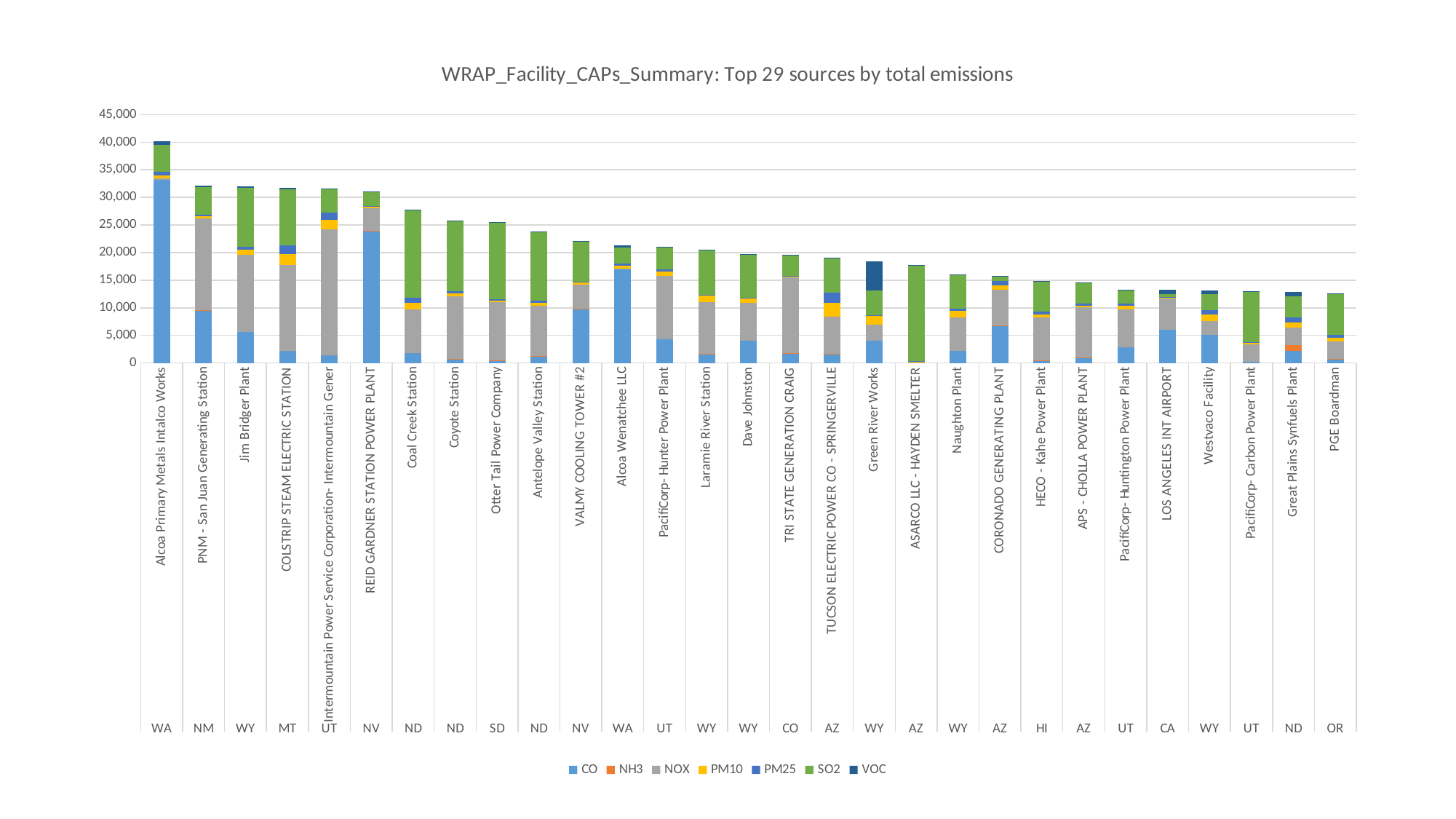
Is the total for PGE Boardman greater or less than 15,000? less Is the total for Alcoa Primary Metals Intalco Works greater or less than 35,000? greater Is the total for Coal Creek Station greater or less than 25,000? greater What is the title of the chart? WRAP_Facility_CAPs_Summary: Top 29 sources by total emissions Do the total emissions rise or fall moving from left to right along the x axis? Fall What kind of chart is shown on the slide? Stacked bar chart Which facility has the highest total emissions? Alcoa Primary Metals Intalco Works Which series makes up almost all of the bar for ASARCO LLC - HAYDEN SMELTER? SO2 Which has the larger total emissions, Alcoa Primary Metals Intalco Works or PNM - San Juan Generating Station? Alcoa Primary Metals Intalco Works How many facilities (bars) are plotted in the chart? 29 Which facility has the lowest total emissions? PGE Boardman How many series does the legend list? 7